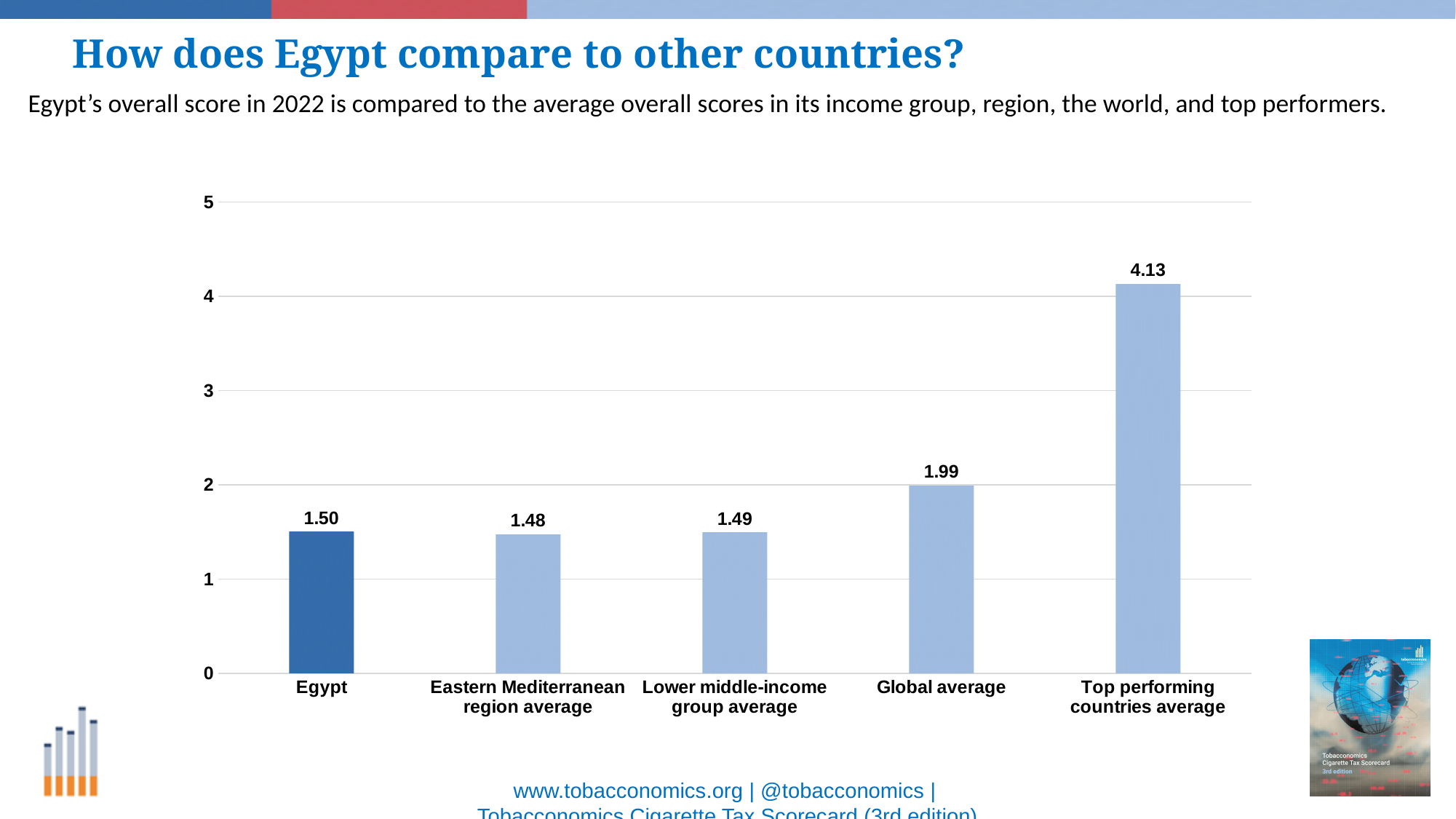
What is the value for the Lower middle-income group average? 1.49 What kind of chart is shown on the slide? Bar chart What is the value for the Eastern Mediterranean region average? 1.48 Is the value for the Top performing countries average greater or less than 4? greater Which category has the highest value? Top performing countries average What is the value for the Global average? 1.99 How many categories are shown in the chart? 5 What is the value for Egypt? 1.50 What is the value for the Top performing countries average? 4.13 What is the difference between the Top performing countries average and Egypt? 2.63 What is the difference between the Global average and Egypt? 0.49 Which is larger, the Global average or Egypt? Global average